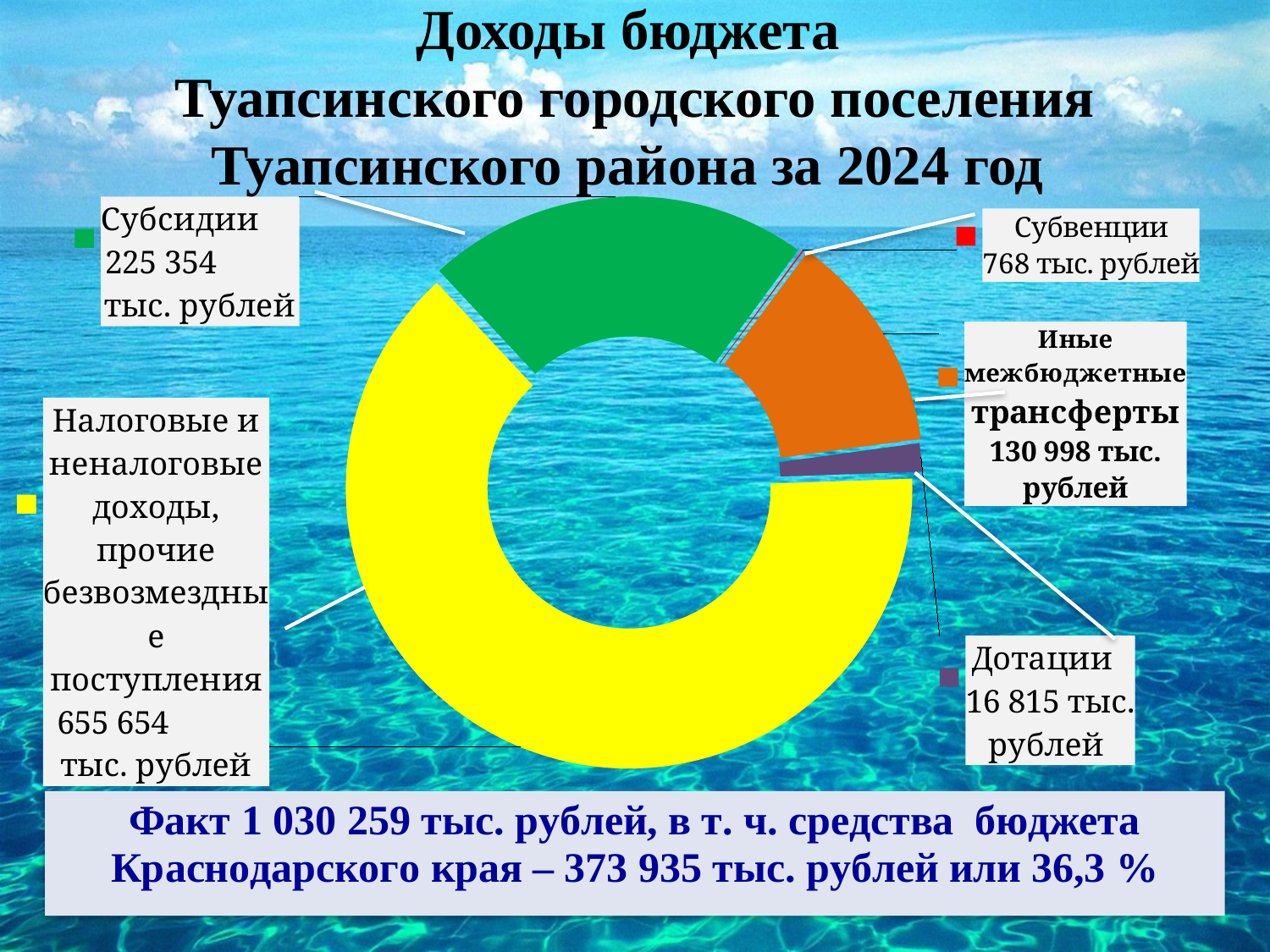
What is the difference between Субсидии and Иные межбюджетные трансферты? 94 356 тыс. рублей Which category has the largest value? Налоговые и неналоговые доходы, прочие безвозмездные поступления What is the value for Субвенции? 768 тыс. рублей What is the value for Субсидии? 225 354 тыс. рублей What is the value for Дотации? 16 815 тыс. рублей Which is larger, Дотации or Иные межбюджетные трансферты? Иные межбюджетные трансферты What type of chart is shown on the slide? doughnut chart How many categories does the doughnut chart show? 5 Which category has the smallest value? Субвенции What is the value for Иные межбюджетные трансферты? 130 998 тыс. рублей What colour is the segment for Субсидии? green What is the value for Налоговые и неналоговые доходы, прочие безвозмездные поступления? 655 654 тыс. рублей